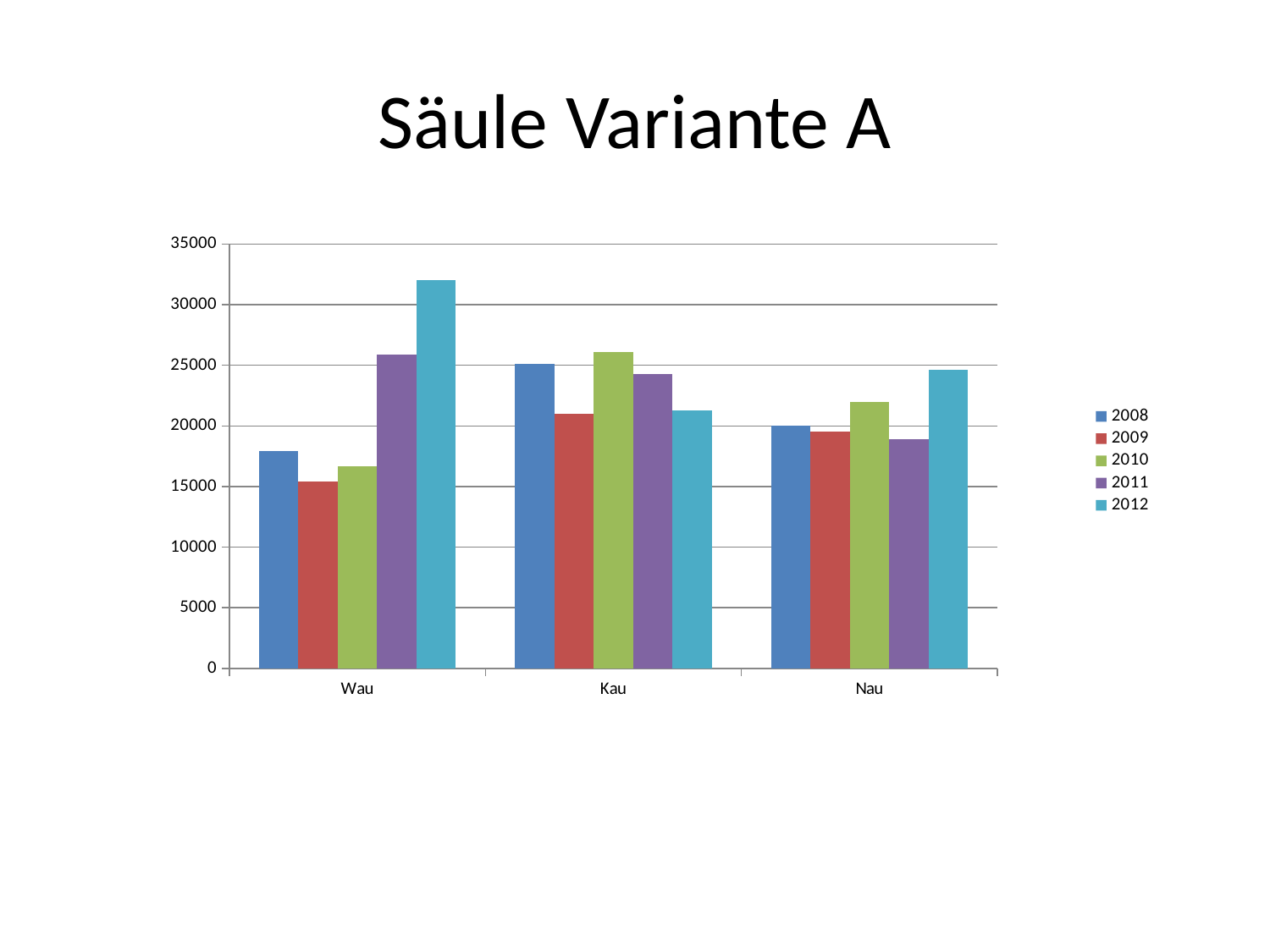
Which series has the lowest bar in the Wau category? 2009 Is the value for 2012 in Wau greater or less than 30000? greater Which is larger: the 2012 value for Wau or the 2012 value for Kau? Wau What kind of chart is shown on the slide? bar chart How many categories are shown on the x axis? 3 How many series does the legend list? 5 Which series has the highest bar in the Kau category? 2010 Which is larger: the 2012 value for Nau or the 2011 value for Nau? 2012 Is the value for 2009 in Kau greater or less than 20000? greater What is the title of the slide? Säule Variante A Which category has the highest bar for the 2012 series? Wau Is the value for 2011 in Nau greater or less than 20000? less